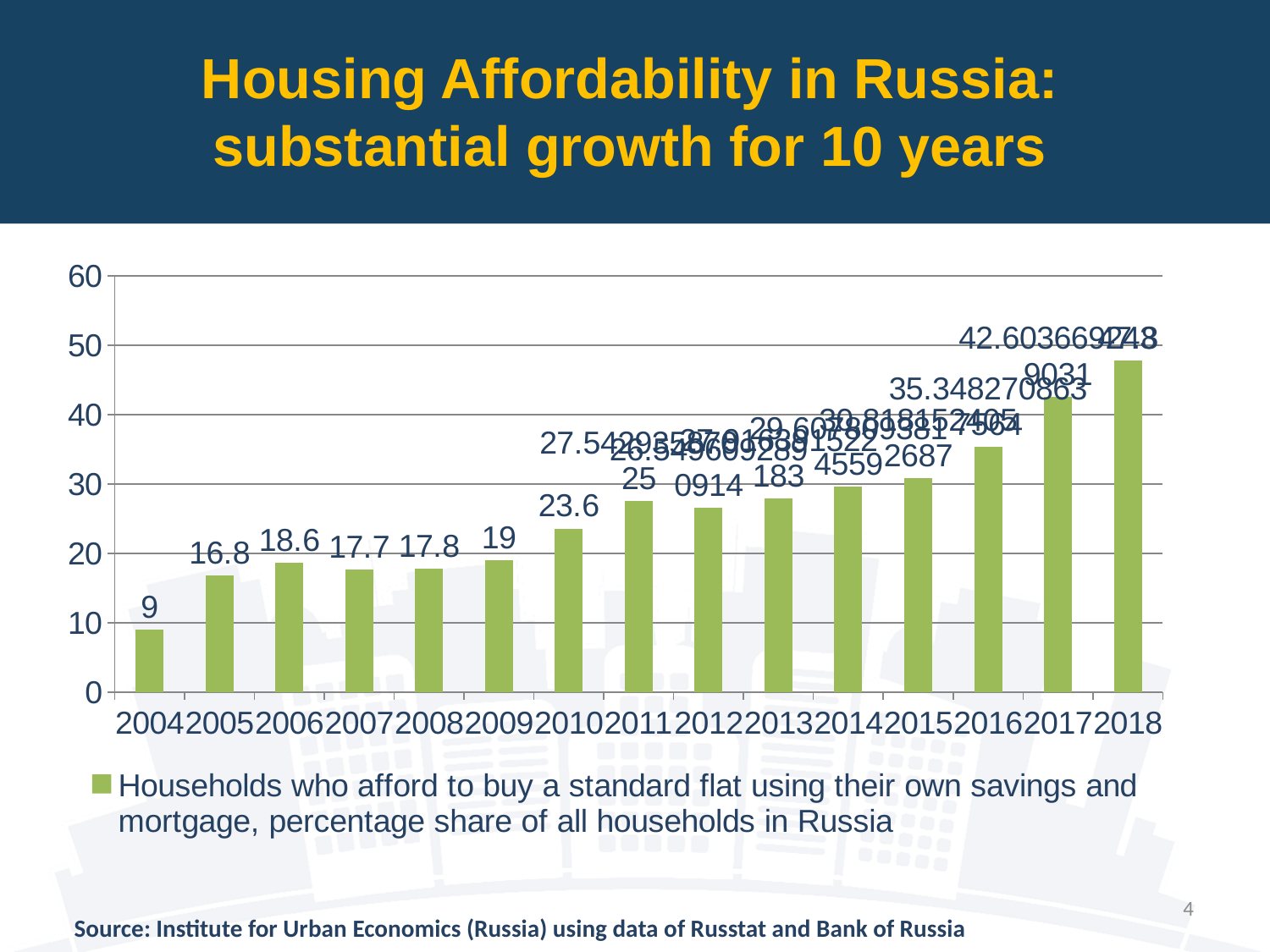
Which year has the lowest value? 2004 Is the value for 2012 greater or less than 30? less What is the value for 2004? 9 What kind of chart is shown on the slide? bar chart How many years are shown on the x axis? 15 Which is larger, the value for 2006 or the value for 2007? 2006 What is the value for 2006? 18.6 Is the value for 2017 greater or less than 40? greater What is the value for 2010? 23.6 What is the difference between the values for 2010 and 2004? 14.6 Do the values generally rise or fall from 2004 to 2018? rise Which year has the highest value? 2018